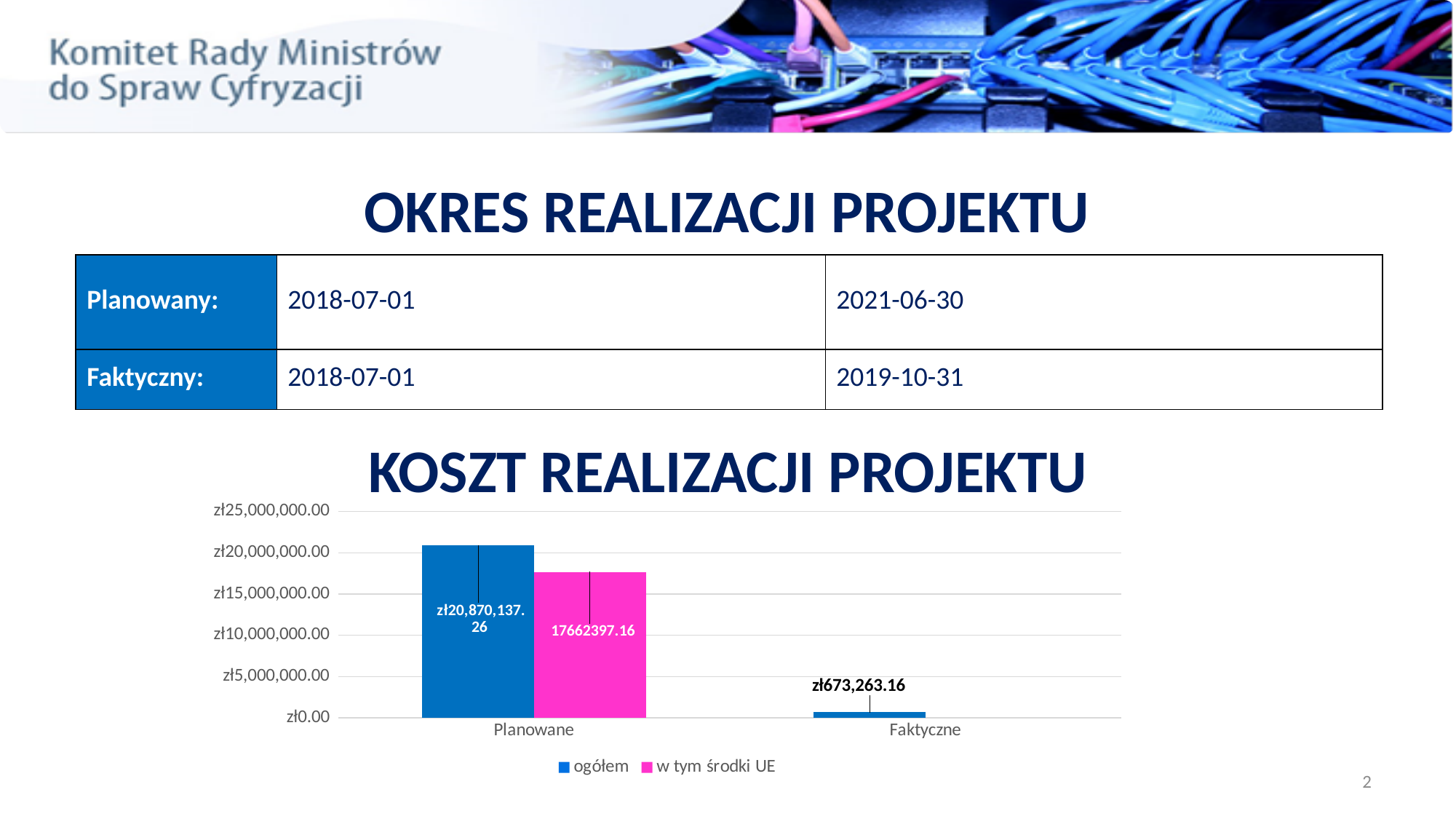
How many series does the legend of the KOSZT REALIZACJI PROJEKTU chart list? 2 In the KOSZT REALIZACJI PROJEKTU chart, which category has the highest ogółem value? Planowane In the KOSZT REALIZACJI PROJEKTU chart, is the ogółem value for Faktyczne greater or less than zł5,000,000.00? less In the KOSZT REALIZACJI PROJEKTU chart, which category has the lowest ogółem value? Faktyczne In the KOSZT REALIZACJI PROJEKTU chart, what is the value of w tym środki UE for Planowane? 17662397.16 In the KOSZT REALIZACJI PROJEKTU chart, what is the value of ogółem for Planowane? zł20,870,137.26 In the KOSZT REALIZACJI PROJEKTU chart, is the ogółem value for Planowane greater or less than zł20,000,000.00? greater What kind of chart is shown under the title KOSZT REALIZACJI PROJEKTU? bar chart In the KOSZT REALIZACJI PROJEKTU chart, which is larger for Planowane: ogółem or w tym środki UE? ogółem In the KOSZT REALIZACJI PROJEKTU chart, what colour are the w tym środki UE bars? pink How many categories are shown on the x axis of the KOSZT REALIZACJI PROJEKTU chart? 2 In the KOSZT REALIZACJI PROJEKTU chart, what is the value of ogółem for Faktyczne? zł673,263.16